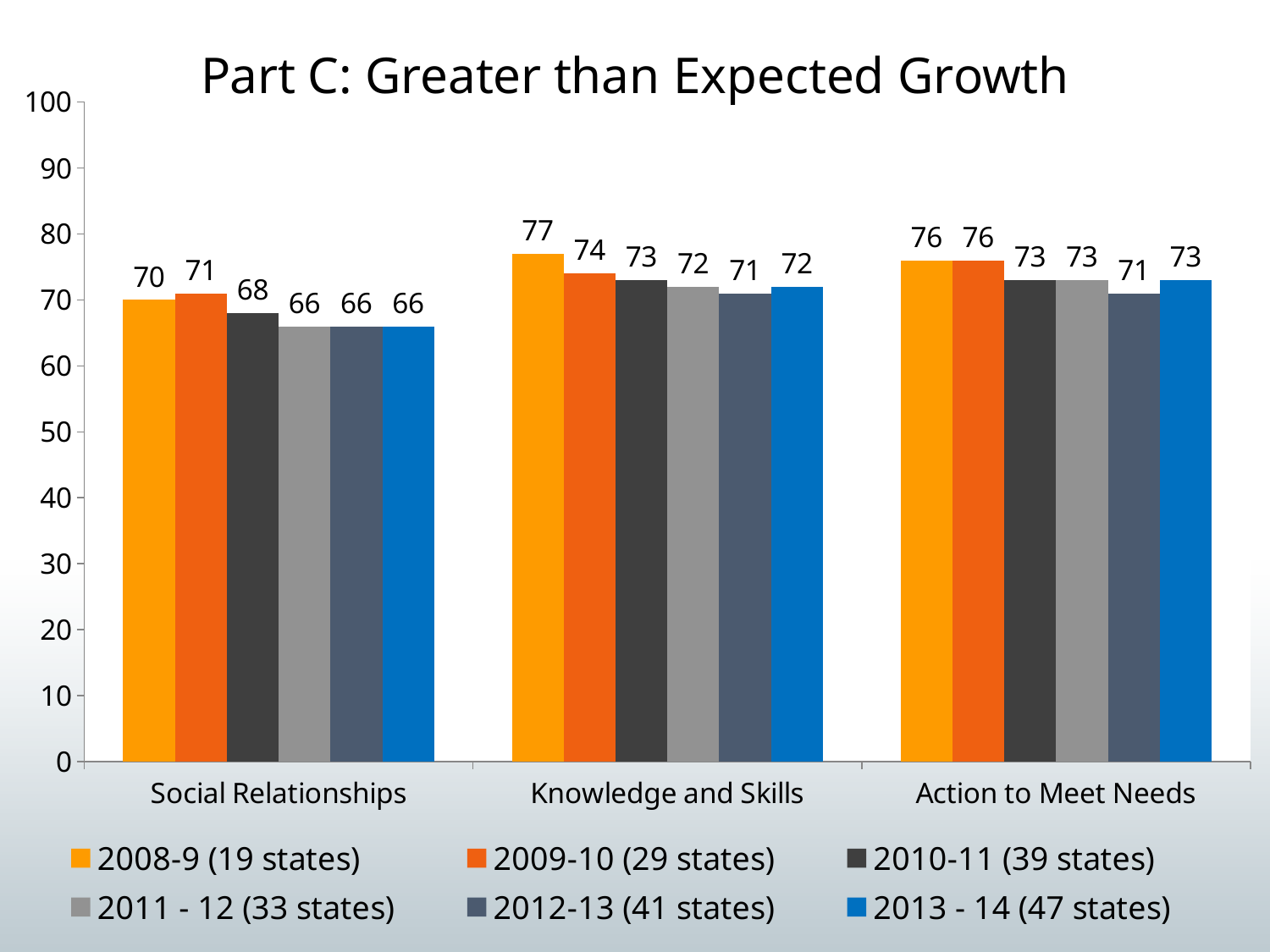
Which category has the lowest value for 2010-11 (39 states)? Social Relationships What is the difference between the 2008-9 (19 states) value and the 2013 - 14 (47 states) value in the Knowledge and Skills category? 5 What is the value for 2012-13 (41 states) in the Action to Meet Needs category? 71 Is the value for 2011 - 12 (33 states) in the Social Relationships category greater or less than 70? less What kind of chart is shown on the slide? Bar chart What is the value for 2008-9 (19 states) in the Knowledge and Skills category? 77 How many categories are shown on the x axis? 3 What is the value for 2013 - 14 (47 states) in the Social Relationships category? 66 How many series does the legend list? 6 What is the title of the chart? Part C: Greater than Expected Growth Which is larger: the 2009-10 (29 states) value for Knowledge and Skills or for Action to Meet Needs? Action to Meet Needs Which series has the highest value in the Social Relationships category? 2009-10 (29 states)